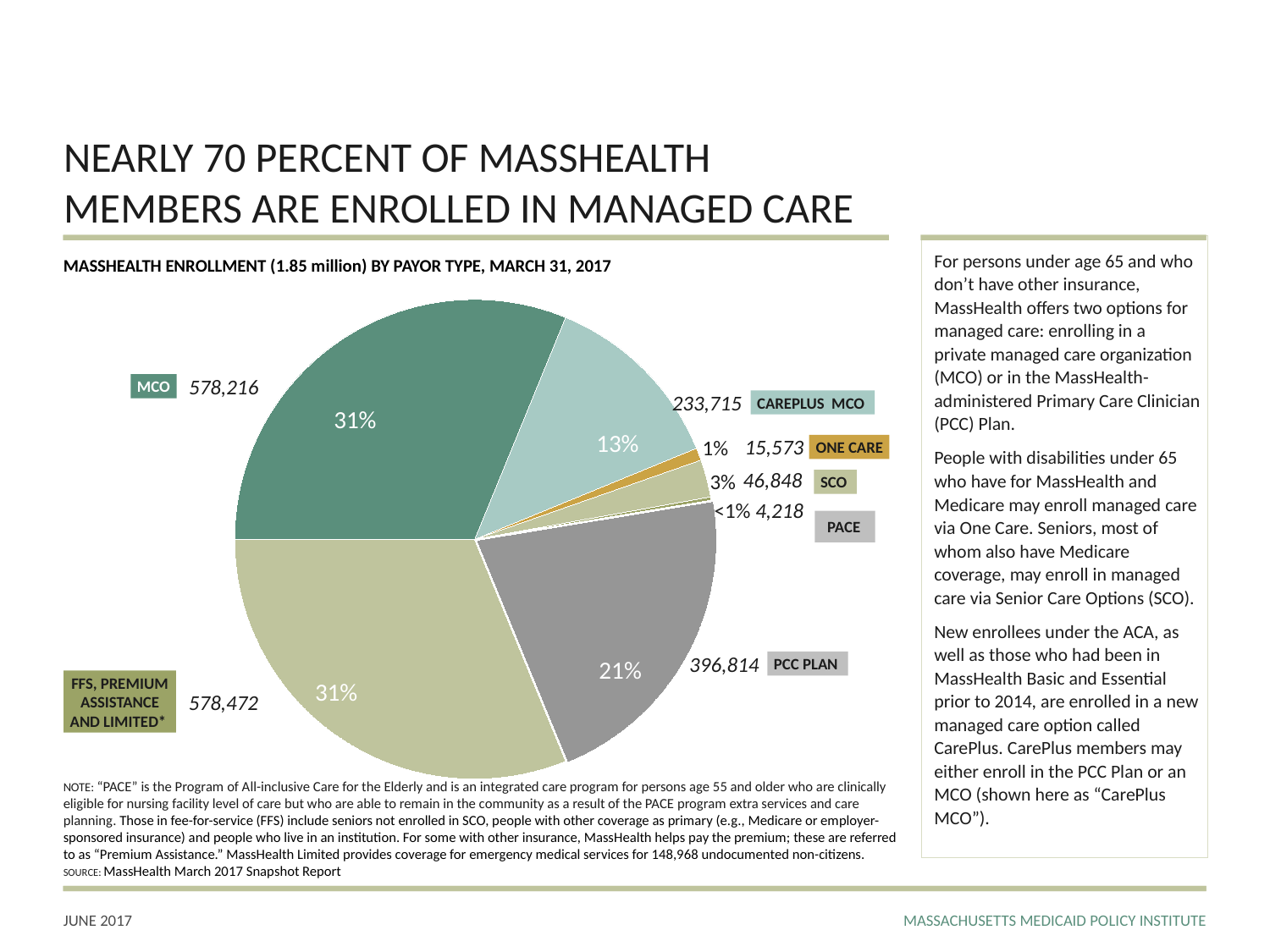
Which has a larger enrollment, SCO or One Care? SCO What type of chart is shown on the slide? Pie chart What is the title of the pie chart? MASSHEALTH ENROLLMENT (1.85 million) BY PAYOR TYPE, MARCH 31, 2017 What is the enrollment value shown for the PCC Plan slice? 396,814 What is the enrollment value shown for CarePlus MCO? 233,715 What is the enrollment value shown for One Care? 15,573 What share of the pie does the PCC Plan slice represent? 21% What is the enrollment value shown for SCO? 46,848 Which payor type has the smallest slice of the pie? PACE How many payor type slices does the pie chart have? 7 What share of the pie does the CarePlus MCO slice represent? 13% What is the difference in enrollment between the PCC Plan and CarePlus MCO? 163,099